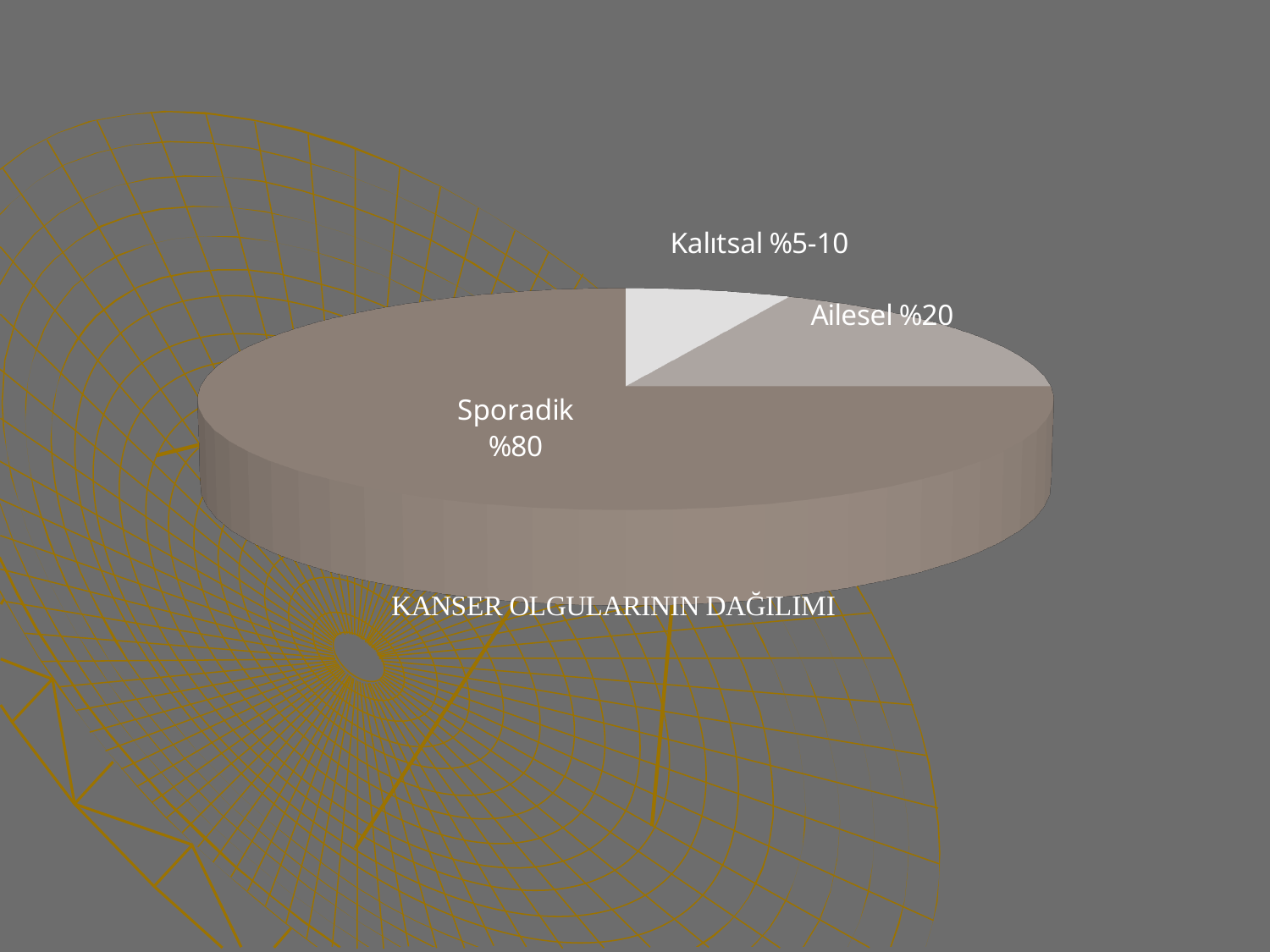
How many slices does the pie chart have? 3 What share of the pie does the Ailesel slice represent? %20 What share of the pie does the Sporadik slice represent? %80 Which slice is shown in the lightest colour? Kalıtsal Which slice of the pie is the smallest? Kalıtsal What is the difference in percentage points between the Sporadik slice and the Ailesel slice? %60 Which is larger, the Ailesel slice or the Kalıtsal slice? Ailesel Which slice of the pie is the largest? Sporadik What value is labelled for the Kalıtsal slice? %5-10 What kind of chart is shown on the slide? pie chart What is the title of the chart? KANSER OLGULARININ DAĞILIMI Which is larger, the Sporadik slice or the Ailesel slice? Sporadik